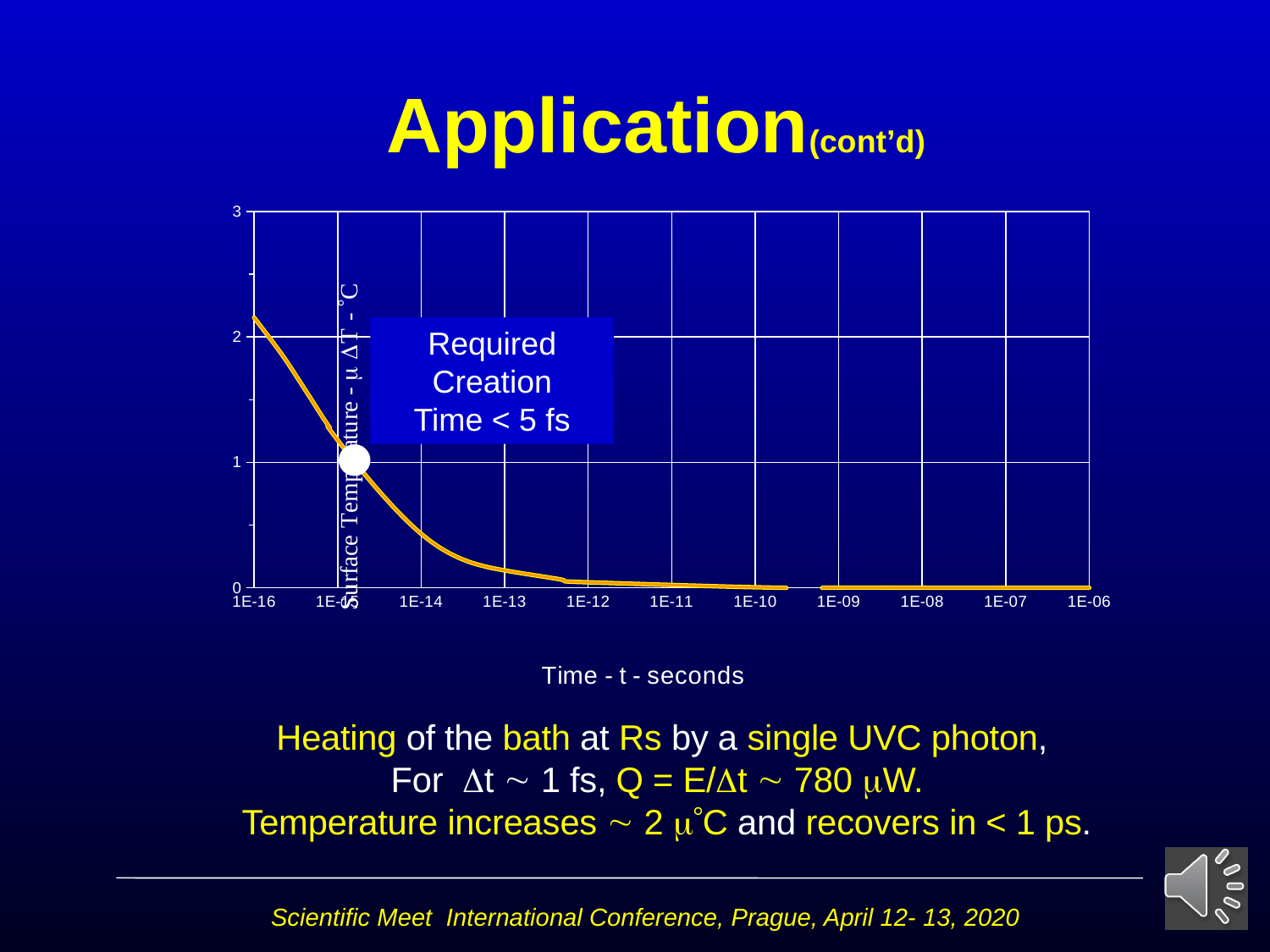
What is the label of the x axis? Time - t - seconds Is the surface temperature at time 1E-14 greater or less than 1? less What kind of chart is shown on the slide? line chart Is the surface temperature at time 1E-16 greater or less than 1? greater At which time on the x axis does the highlighted marker on the curve sit at a surface temperature of 1? 1E-15 What does the text box overlaid on the chart say? Required Creation Time < 5 fs Does the surface temperature rise or fall as time increases along the x axis? fall Is the surface temperature at time 1E-13 greater or less than 1? less What is the highest value shown on the y axis? 3 What is the first (leftmost) tick label on the x axis? 1E-16 How many tick labels are shown along the x axis? 11 What is the last (rightmost) tick label on the x axis? 1E-06